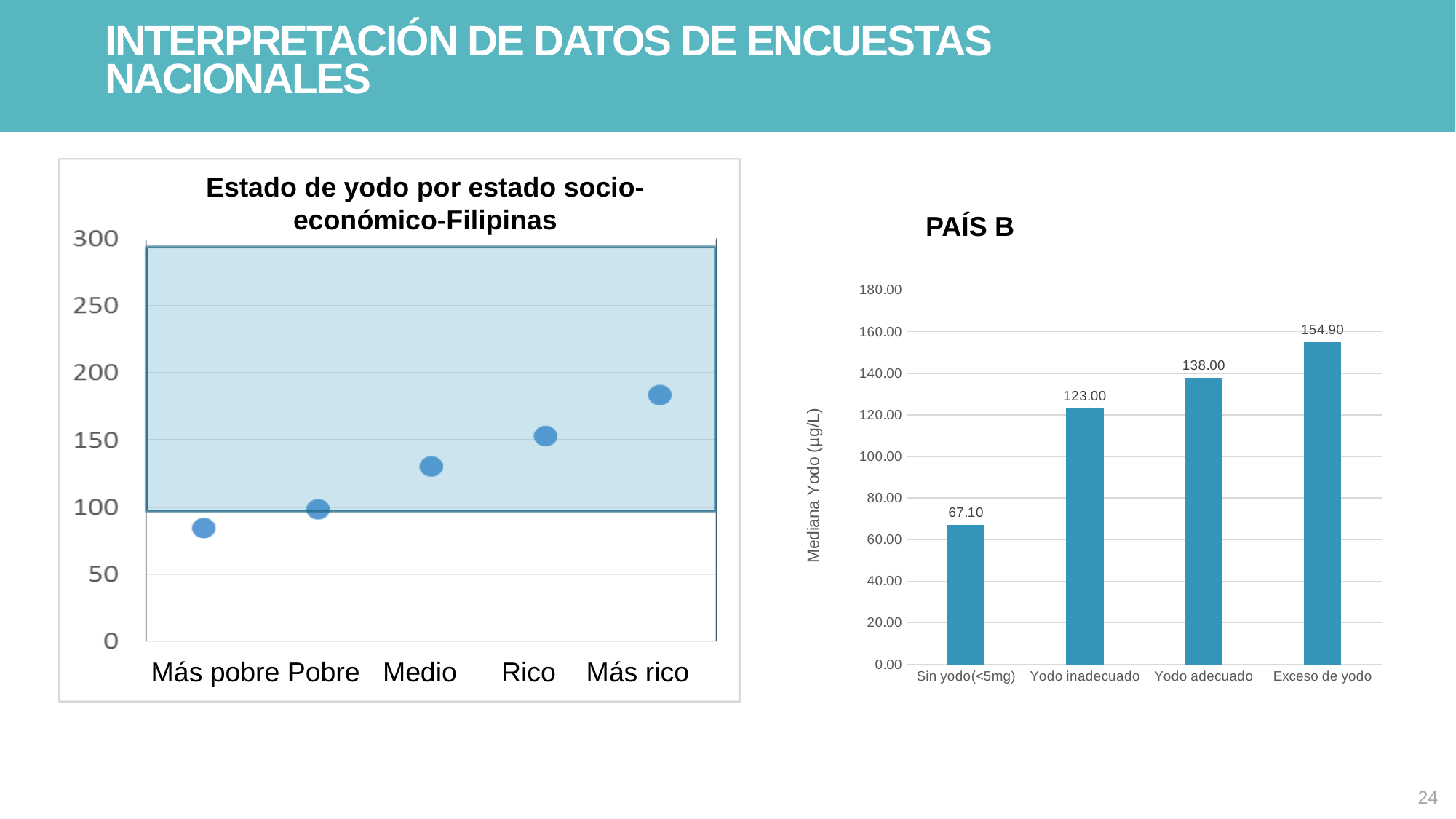
In the 'Estado de yodo por estado socio-económico-Filipinas' chart, how many data points are plotted? 5 In the 'PAÍS B' chart, how many categories are shown? 4 In the 'PAÍS B' chart, which category has the highest value? Exceso de yodo What kind of chart is the 'PAÍS B' chart? Bar chart In the 'PAÍS B' chart, what is the value for Exceso de yodo? 154.90 In the 'Estado de yodo por estado socio-económico-Filipinas' chart, do the values rise or fall from Más pobre to Más rico? Rise In the 'PAÍS B' chart, what is the difference between Yodo adecuado and Yodo inadecuado? 15.00 In the 'Estado de yodo por estado socio-económico-Filipinas' chart, is the value for Más pobre greater or less than 100? less In the 'Estado de yodo por estado socio-económico-Filipinas' chart, is the value for Más rico greater or less than 150? greater In the 'PAÍS B' chart, what is the value for Yodo inadecuado? 123.00 In the 'PAÍS B' chart, which category has the lowest value? Sin yodo(<5mg) In the 'PAÍS B' chart, what is the value for Sin yodo(<5mg)? 67.10